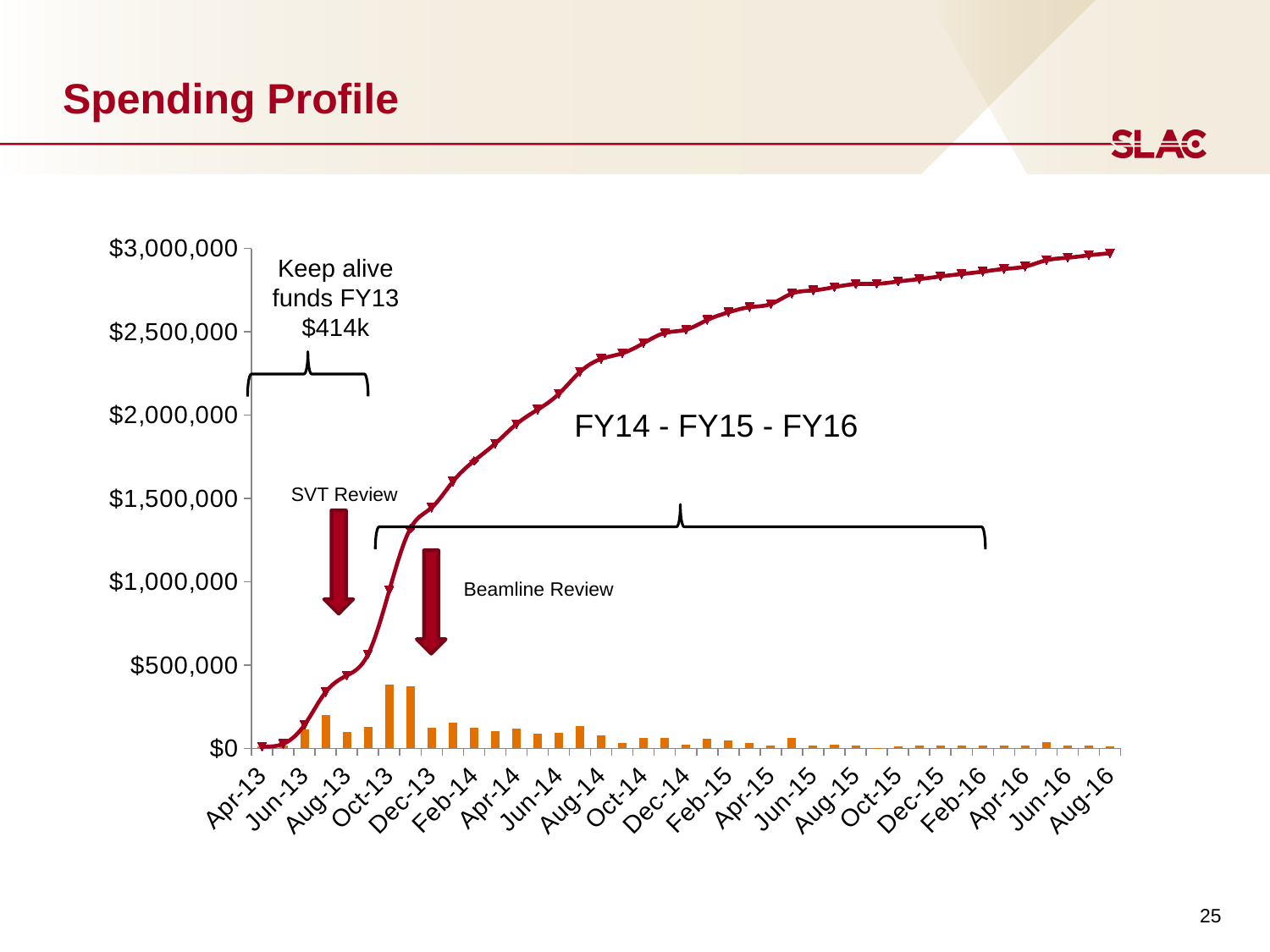
Which is larger, the red line value at Dec-13 or at Jun-13? Dec-13 What is the title of the slide containing the chart? Spending Profile Do the orange bars generally rise or fall from Dec-13 to Aug-16? Fall How many month labels are shown on the x axis? 21 Is the value of the red line at Aug-16 greater or less than $2,500,000? greater What kinds of chart are combined in this chart? A bar chart and a line chart What is the highest value shown on the y axis? $3,000,000 Is the tallest orange bar greater or less than $500,000? less Is the value of the red line at Aug-14 greater or less than $2,000,000? greater Does the red line rise or fall from Apr-13 to Aug-16? Rises